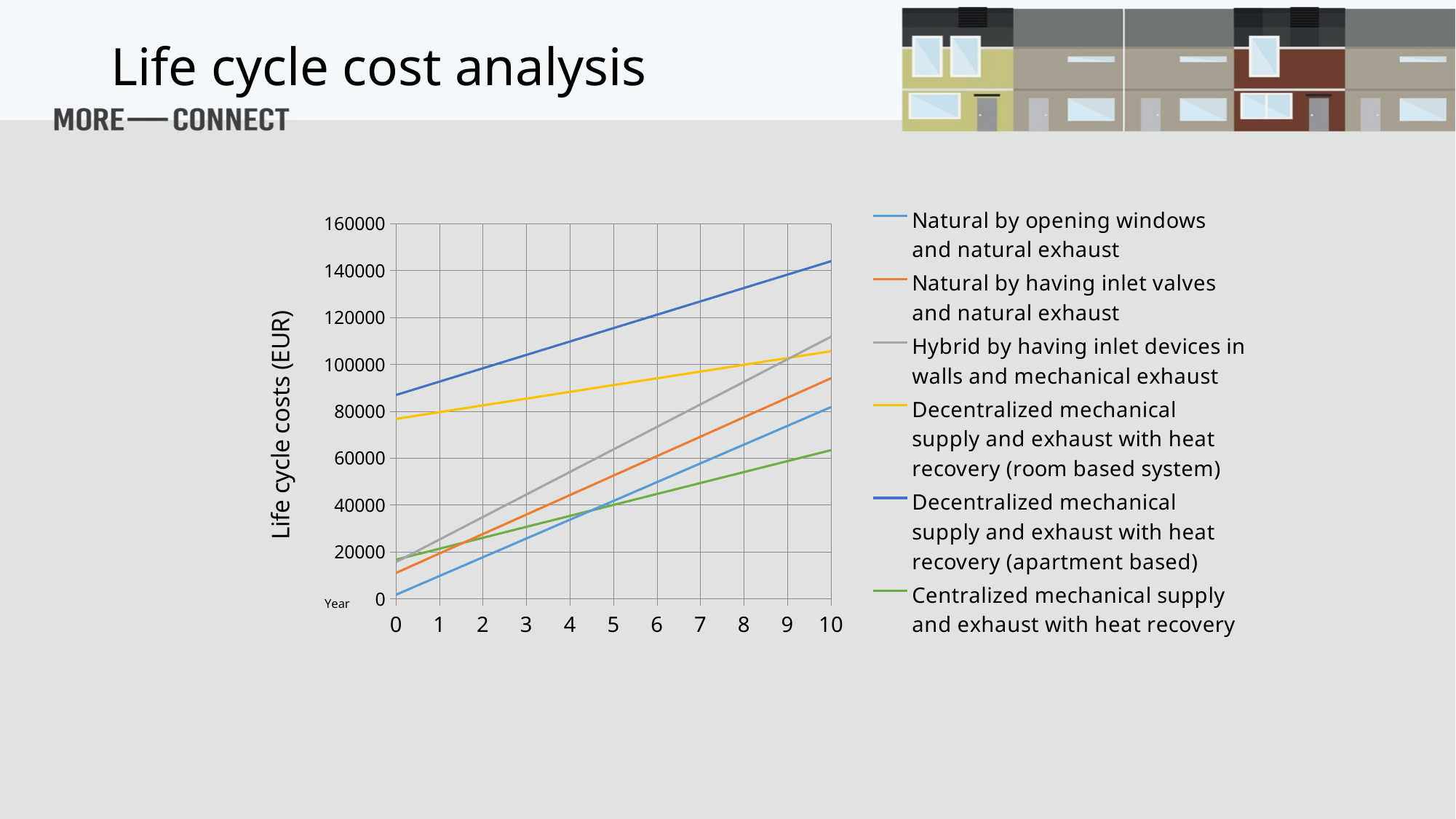
Is the value for Centralized mechanical supply and exhaust with heat recovery at year 10 greater or less than 80000? less Which series has the highest life cycle cost at year 10? Decentralized mechanical supply and exhaust with heat recovery (apartment based) How many year values are marked along the x axis? 11 At year 10, which is larger: the value for Hybrid by having inlet devices in walls and mechanical exhaust or the value for Natural by having inlet valves and natural exhaust? Hybrid by having inlet devices in walls and mechanical exhaust How many series does the legend list? 6 Is the value for Decentralized mechanical supply and exhaust with heat recovery (room based system) at year 0 greater or less than 60000? greater Which series has the lowest life cycle cost at year 0? Natural by opening windows and natural exhaust What kind of chart is shown on the slide? line chart Which series has the lowest life cycle cost at year 10? Centralized mechanical supply and exhaust with heat recovery What is the label of the vertical axis? Life cycle costs (EUR) Is the value for Decentralized mechanical supply and exhaust with heat recovery (apartment based) at year 10 greater or less than 120000? greater Do the life cycle costs rise or fall as the years increase? rise